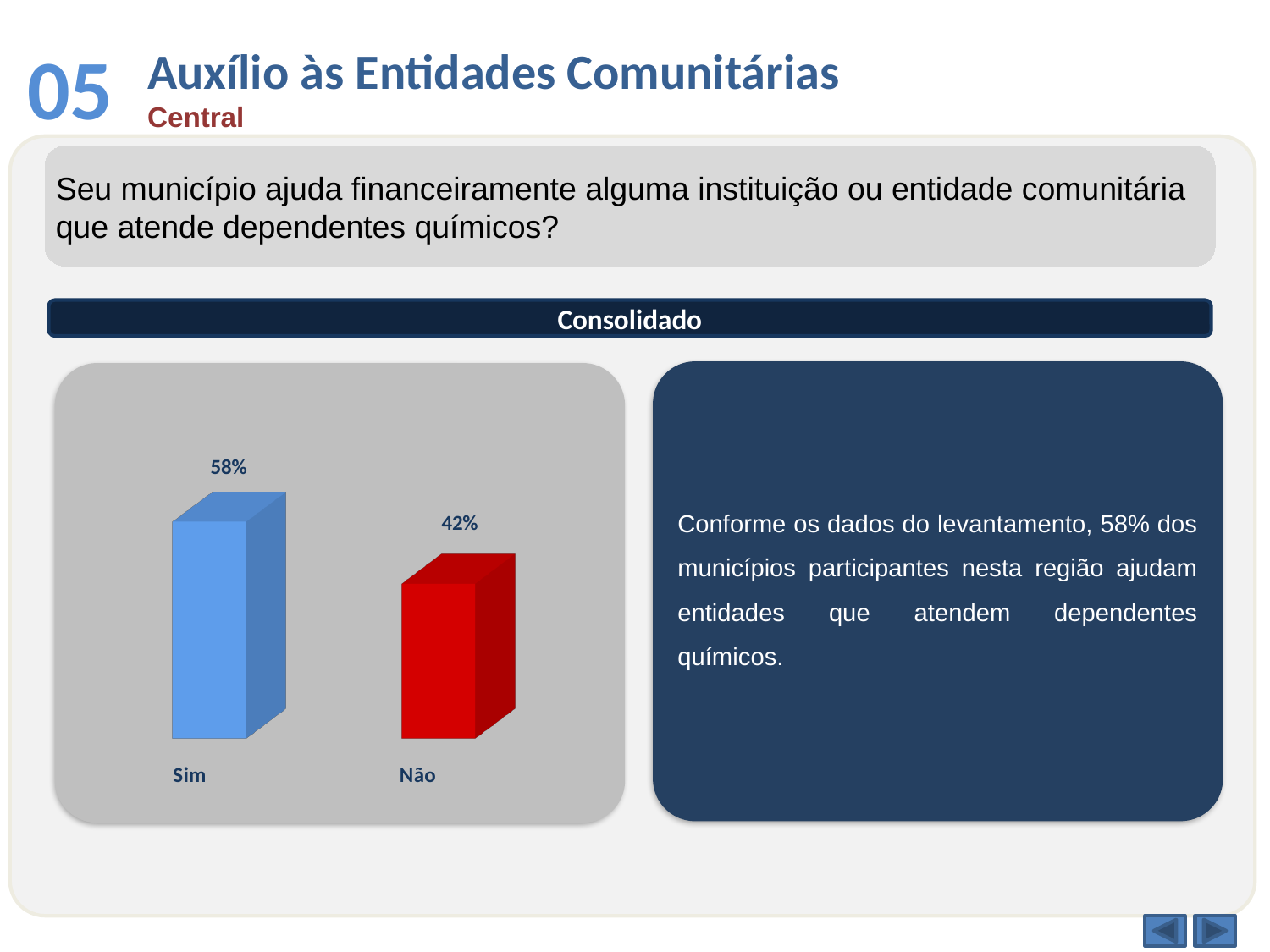
What colour is the bar for Não? Red What is the difference between the values for Sim and Não? 16% Which is larger, the value for Sim or the value for Não? Sim How many categories are shown in the chart? 2 Which category has the highest value? Sim What kind of chart is shown on the slide? Bar chart What is the value for Não? 42% Which category has the lowest value? Não What is the value for Sim? 58% What colour is the bar for Sim? Blue What is the total of the values for Sim and Não? 100%